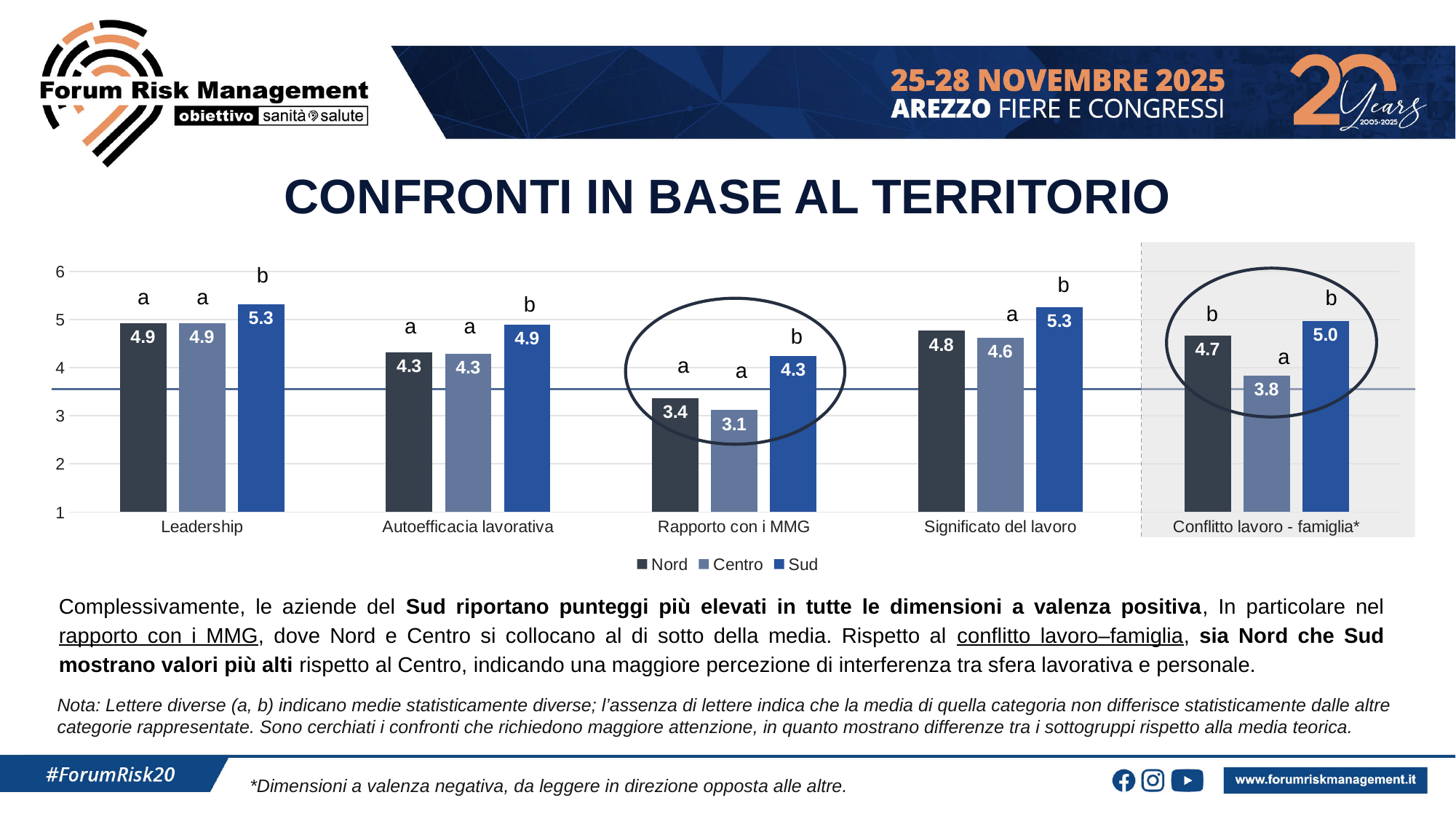
What kind of chart is shown on the slide? Bar chart Which category has the lowest value for the Centro series? Rapporto con i MMG What is the value for Centro in the Rapporto con i MMG category? 3.1 In the Autoefficacia lavorativa category, which is larger: the value for Sud or the value for Nord? Sud What is the value for Nord in the Conflitto lavoro - famiglia* category? 4.7 What is the value for Sud in the Leadership category? 5.3 What is the difference between the Sud and Nord values in the Rapporto con i MMG category? 0.9 Which series has the highest value in the Significato del lavoro category? Sud How many series does the legend list? 3 How many categories are shown on the x axis of the chart? 5 What is the difference between the Sud and Centro values in the Conflitto lavoro - famiglia* category? 1.2 What are the series names listed in the chart legend? Nord, Centro, Sud